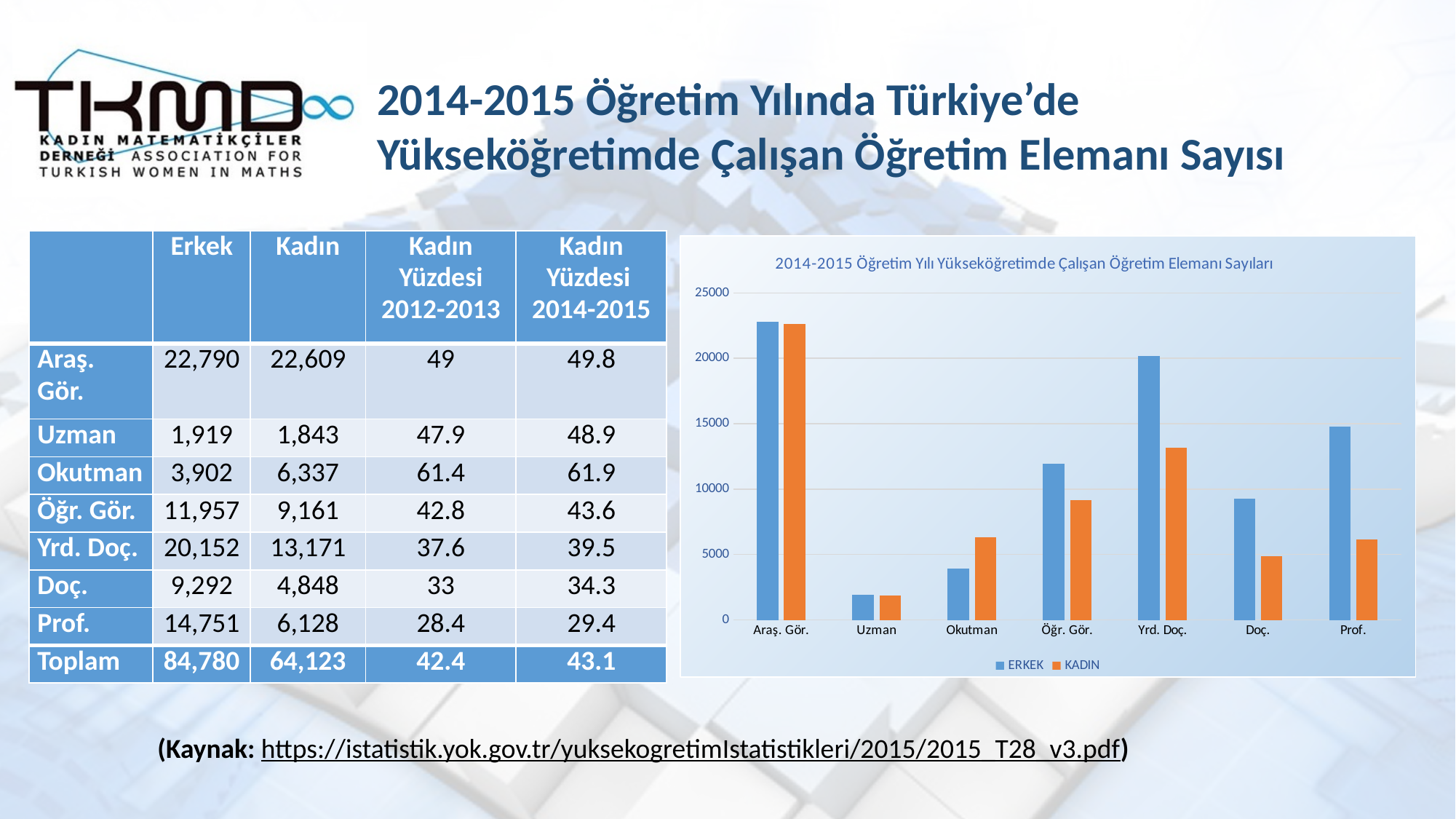
How many categories are shown on the x axis of the chart? 7 Which category has the lowest KADIN value in the chart? Uzman Is the ERKEK value for Okutman greater or less than 5000? less Which colour represents the KADIN series in the chart? orange Is the KADIN value for Prof. greater or less than 5000? greater How many series does the chart legend list? 2 What is the title of the chart? 2014-2015 Öğretim Yılı Yükseköğretimde Çalışan Öğretim Elemanı Sayıları In the chart, which is larger for Prof.: the ERKEK bar or the KADIN bar? ERKEK What kind of chart is shown on the slide? bar chart Is the ERKEK value for Yrd. Doç. greater or less than 20000? greater In the chart, which is larger for Okutman: the ERKEK bar or the KADIN bar? KADIN Which category has the highest ERKEK value in the chart? Araş. Gör.